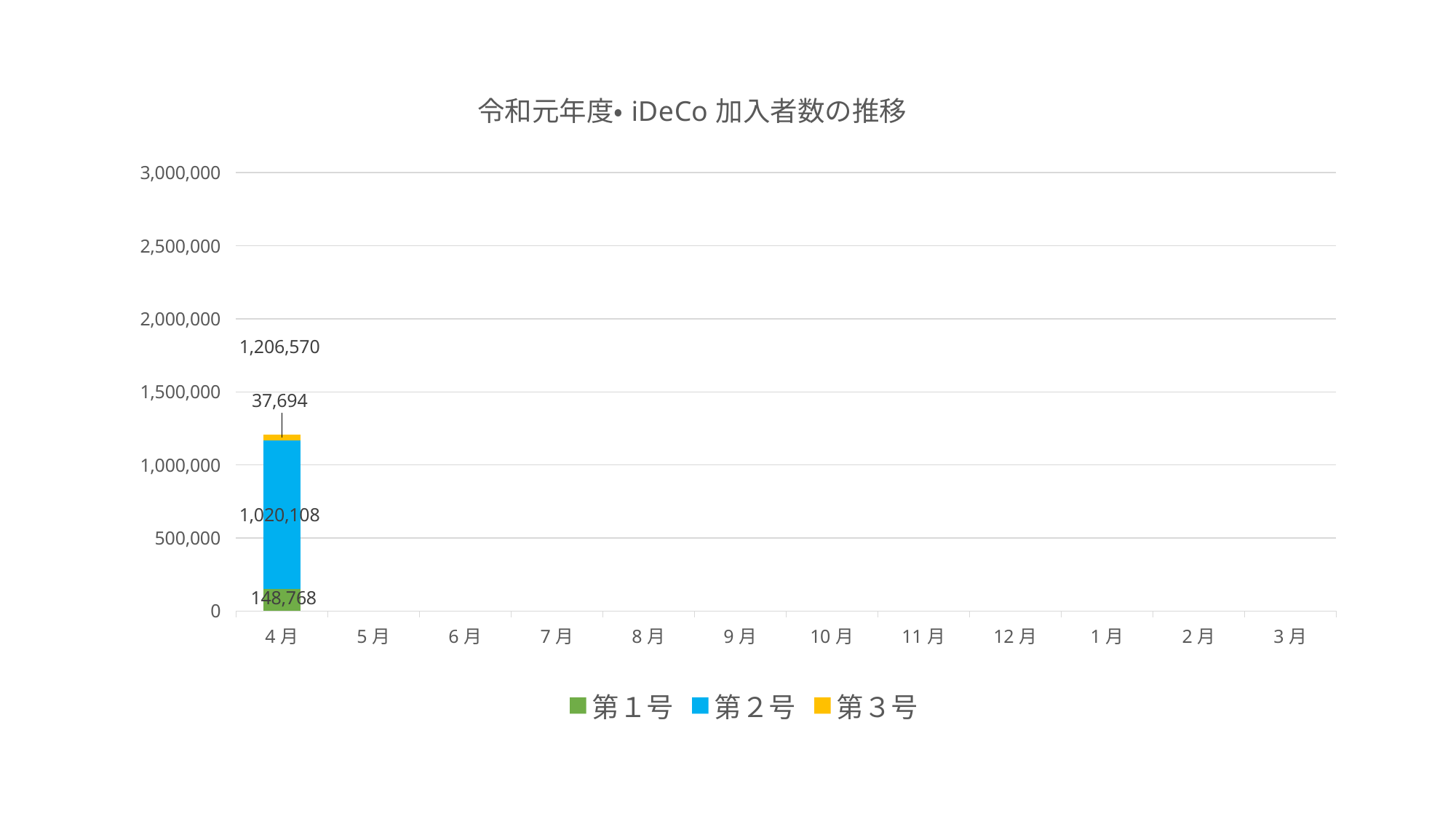
Which series has the largest value in 4月? 第２号 What is the title of the chart? 令和元年度• iDeCo 加入者数の推移 What is the value for 第２号 in 4月? 1,020,108 What is the value for 第１号 in 4月? 148,768 How many month categories are shown on the x axis? 12 What kind of chart is shown on the slide? stacked bar chart What is the difference between 第１号 and 第３号 in 4月? 111,074 Which series has the smallest value in 4月? 第３号 What is the total of the stacked bar for 4月? 1,206,570 What is the value for 第３号 in 4月? 37,694 Which is larger in 4月, 第１号 or 第３号? 第１号 How many series does the legend list? 3